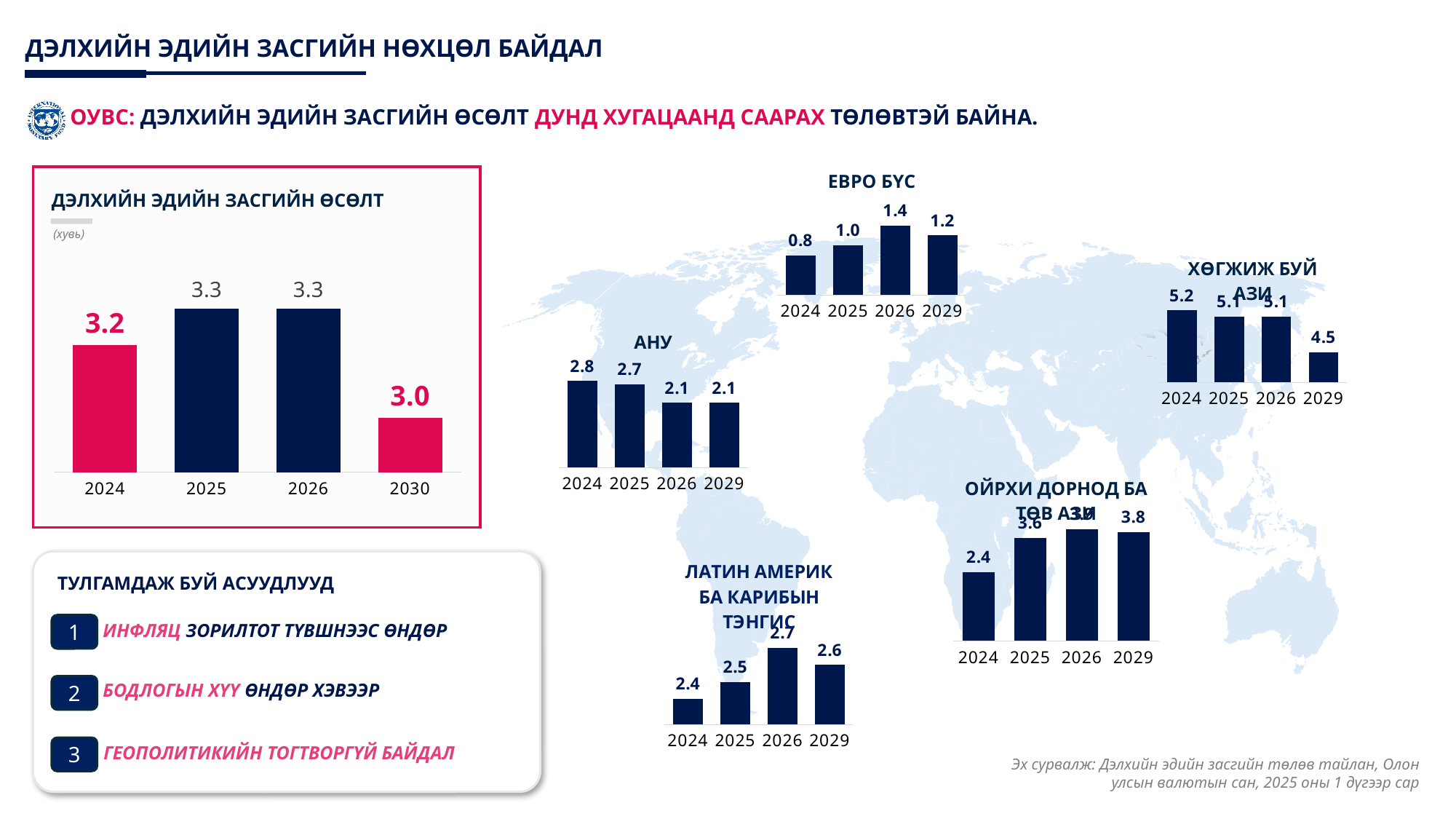
In the "ЛАТИН АМЕРИК БА КАРИБЫН ТЭНГИС" chart, which is larger, the value for 2026 or the value for 2024? 2026 In the "АНУ" chart, what is the value for 2029? 2.1 What type of chart is the "ОЙРХИ ДОРНОД БА ТӨВ АЗИ" chart? bar chart In the "ДЭЛХИЙН ЭДИЙН ЗАСГИЙН ӨСӨЛТ" chart, what is the value for 2030? 3.0 In the "ЕВРО БҮС" chart, what is the value for 2024? 0.8 In the "ДЭЛХИЙН ЭДИЙН ЗАСГИЙН ӨСӨЛТ" chart, how many bars are shown? 4 In the "АНУ" chart, do the values rise or fall from 2024 to 2029? fall In the "ДЭЛХИЙН ЭДИЙН ЗАСГИЙН ӨСӨЛТ" chart, what is the value for 2024? 3.2 In the "ХӨГЖИЖ БУЙ АЗИ" chart, what is the difference between the 2024 value and the 2029 value? 0.7 In the "ЕВРО БҮС" chart, which year has the highest value? 2026 In the "ХӨГЖИЖ БУЙ АЗИ" chart, which year has the lowest value? 2029 In the "ДЭЛХИЙН ЭДИЙН ЗАСГИЙН ӨСӨЛТ" chart, what is the difference between the 2025 value and the 2030 value? 0.3